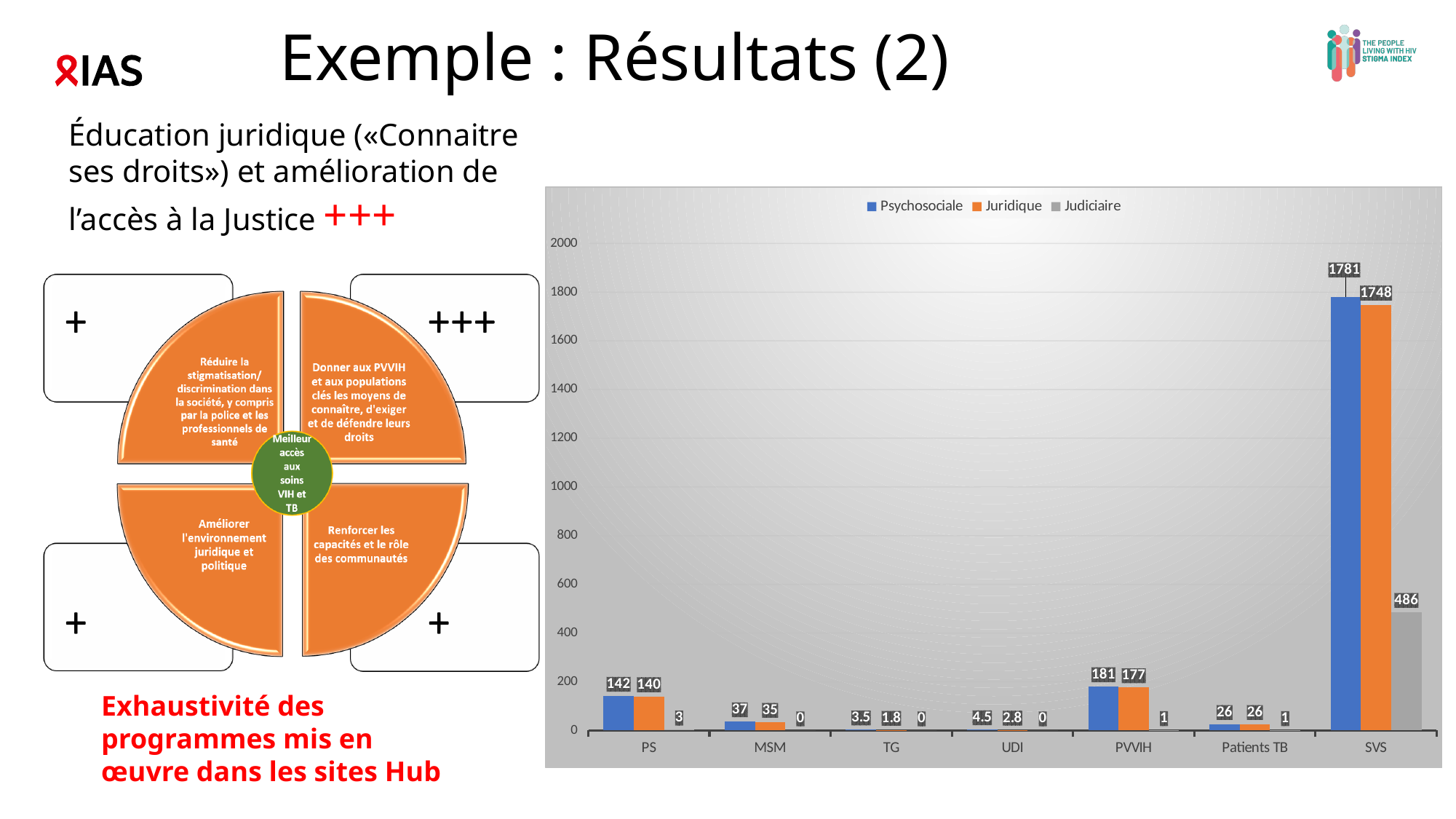
Which is larger, the Psychosociale value for PS or the Psychosociale value for PVVIH? PVVIH What kind of chart is shown on the slide? Bar chart What is the difference between the Psychosociale and Juridique values for SVS? 33 What are the three series named in the legend? Psychosociale, Juridique, Judiciaire What is the Juridique value for PVVIH? 177 What is the Juridique value for TG? 1.8 How many categories are shown on the x axis? 7 How many series does the legend list? 3 Which category has the highest Psychosociale value? SVS What is the Judiciaire value for SVS? 486 Which category has the lowest Psychosociale value? TG What is the Psychosociale value for SVS? 1781